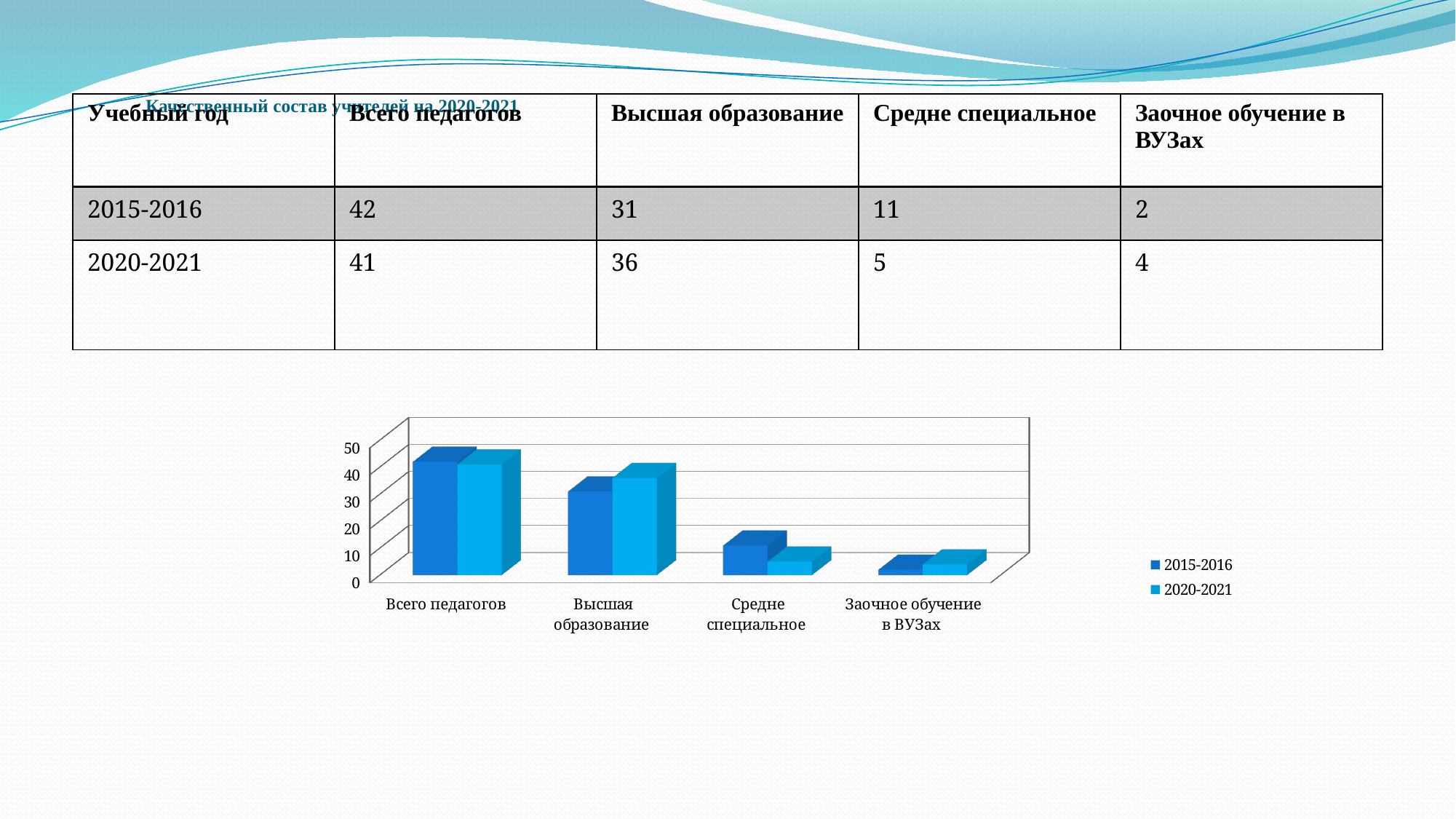
How many series does the chart legend list? 2 How many categories are shown on the x axis of the chart? 4 What is the value for Высшая образование in 2020-2021, as given in the table above the chart? 36 For Средне специальное, which series has the larger value, 2015-2016 or 2020-2021? 2015-2016 What is the difference between the 2015-2016 and 2020-2021 values for Средне специальное, using the table values? 6 Is the 2020-2021 value for Средне специальное greater or less than 10? less Which category has the lowest bars in the chart? Заочное обучение в ВУЗах What are the two entries in the chart legend? 2015-2016 and 2020-2021 What kind of chart is shown on the slide? bar chart Is the 2015-2016 value for Всего педагогов greater or less than 40? greater Which category has the highest bars in the chart? Всего педагогов For Высшая образование, which series has the larger value, 2015-2016 or 2020-2021? 2020-2021